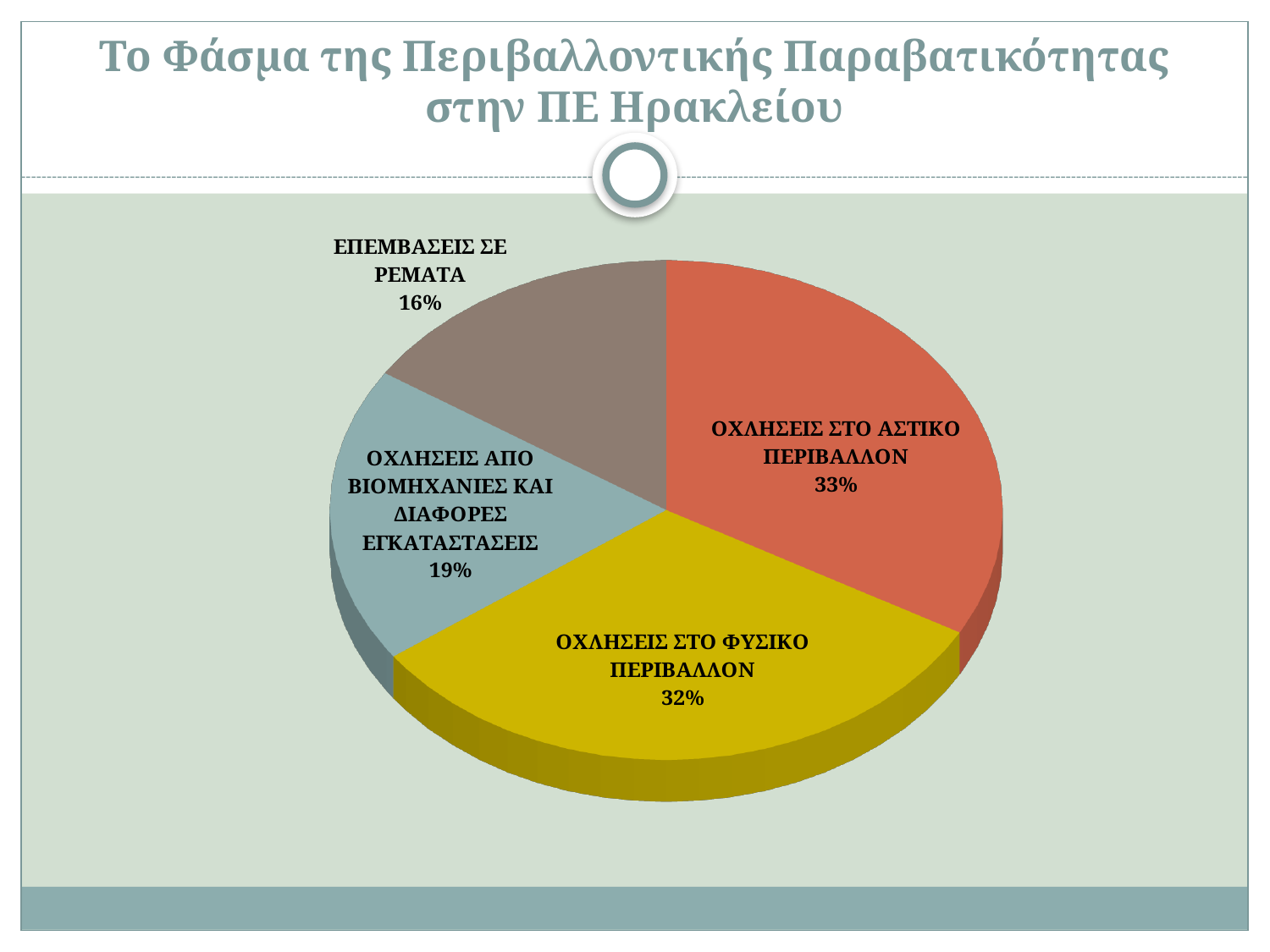
What share of the pie is ΟΧΛΗΣΕΙΣ ΣΤΟ ΑΣΤΙΚΟ ΠΕΡΙΒΑΛΛΟΝ? 33% What kind of chart is shown on the slide? pie chart What share of the pie is ΟΧΛΗΣΕΙΣ ΣΤΟ ΦΥΣΙΚΟ ΠΕΡΙΒΑΛΛΟΝ? 32% What is the difference in percentage points between ΟΧΛΗΣΕΙΣ ΑΠΟ ΒΙΟΜΗΧΑΝΙΕΣ ΚΑΙ ΔΙΑΦΟΡΕΣ ΕΓΚΑΤΑΣΤΑΣΕΙΣ and ΕΠΕΜΒΑΣΕΙΣ ΣΕ ΡΕΜΑΤΑ? 3% What colour is the slice for ΟΧΛΗΣΕΙΣ ΣΤΟ ΦΥΣΙΚΟ ΠΕΡΙΒΑΛΛΟΝ? yellow How many slices does the pie chart have? 4 Which category has the largest share of the pie? ΟΧΛΗΣΕΙΣ ΣΤΟ ΑΣΤΙΚΟ ΠΕΡΙΒΑΛΛΟΝ Which is larger: the share for ΟΧΛΗΣΕΙΣ ΣΤΟ ΦΥΣΙΚΟ ΠΕΡΙΒΑΛΛΟΝ or the share for ΟΧΛΗΣΕΙΣ ΑΠΟ ΒΙΟΜΗΧΑΝΙΕΣ ΚΑΙ ΔΙΑΦΟΡΕΣ ΕΓΚΑΤΑΣΤΑΣΕΙΣ? ΟΧΛΗΣΕΙΣ ΣΤΟ ΦΥΣΙΚΟ ΠΕΡΙΒΑΛΛΟΝ Which category has the smallest share of the pie? ΕΠΕΜΒΑΣΕΙΣ ΣΕ ΡΕΜΑΤΑ What share of the pie is ΟΧΛΗΣΕΙΣ ΑΠΟ ΒΙΟΜΗΧΑΝΙΕΣ ΚΑΙ ΔΙΑΦΟΡΕΣ ΕΓΚΑΤΑΣΤΑΣΕΙΣ? 19% What is the title of the slide containing the pie chart? Το Φάσμα της Περιβαλλοντικής Παραβατικότητας στην ΠΕ Ηρακλείου